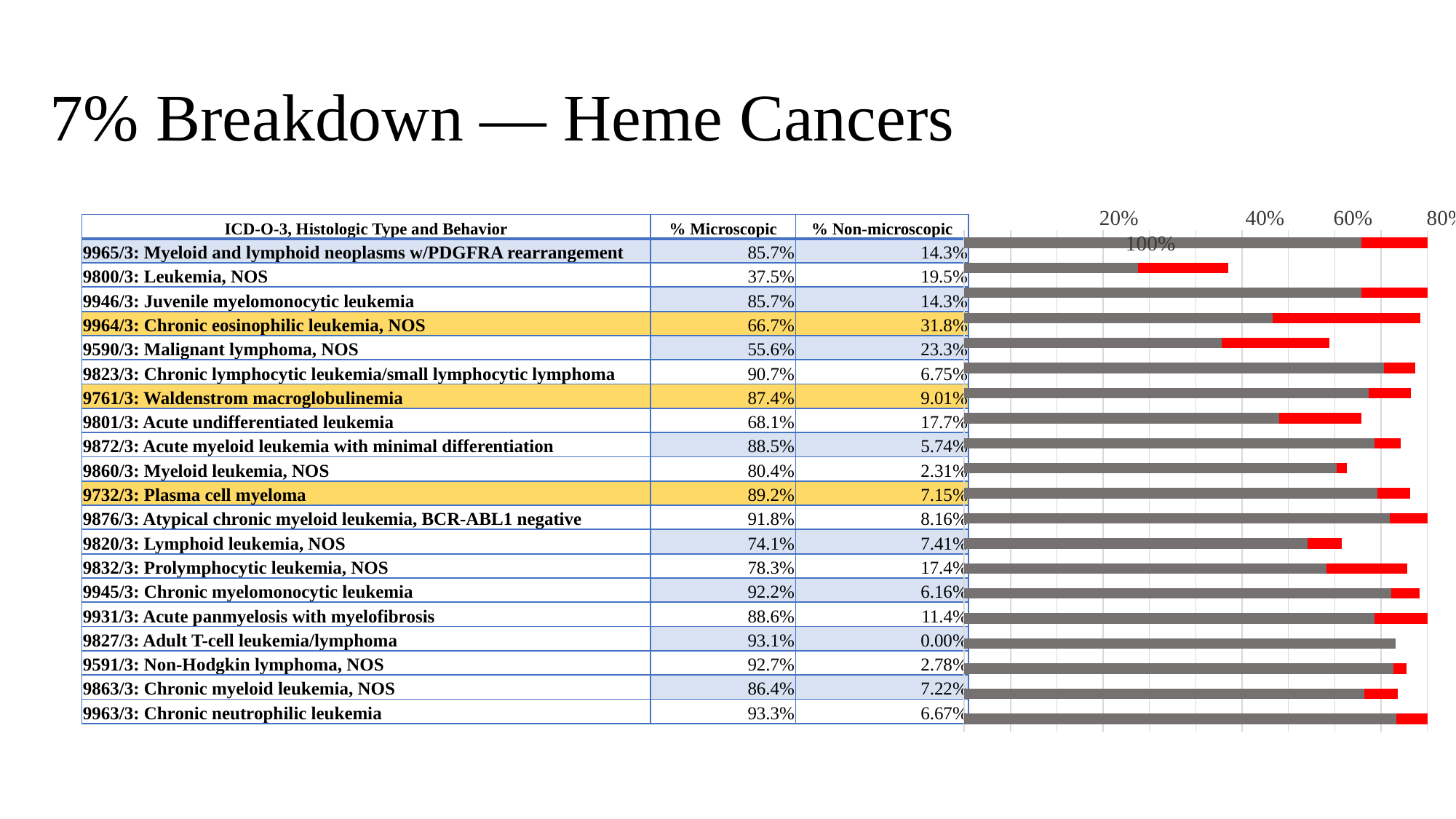
Which histologic type has the highest % Non-microscopic value? 9964/3: Chronic eosinophilic leukemia, NOS Which histologic type has the highest % Microscopic value? 9963/3: Chronic neutrophilic leukemia What is the % Microscopic value for 9800/3: Leukemia, NOS? 37.5% What is the % Microscopic value for 9732/3: Plasma cell myeloma? 89.2% What is the % Non-microscopic value for 9964/3: Chronic eosinophilic leukemia, NOS? 31.8% Which has a larger % Non-microscopic value: 9590/3: Malignant lymphoma, NOS or 9860/3: Myeloid leukemia, NOS? 9590/3: Malignant lymphoma, NOS What is the difference in % Microscopic between 9963/3: Chronic neutrophilic leukemia and 9800/3: Leukemia, NOS? 55.8 percentage points What is the % Non-microscopic value for 9827/3: Adult T-cell leukemia/lymphoma? 0.00% What kind of chart is shown on the right of the slide? Stacked horizontal bar chart How many categories (histologic types) are plotted in the bar chart? 20 What is the total of the stacked bar (% Microscopic plus % Non-microscopic) for 9946/3: Juvenile myelomonocytic leukemia? 100.0% Which histologic type has the lowest % Microscopic value? 9800/3: Leukemia, NOS